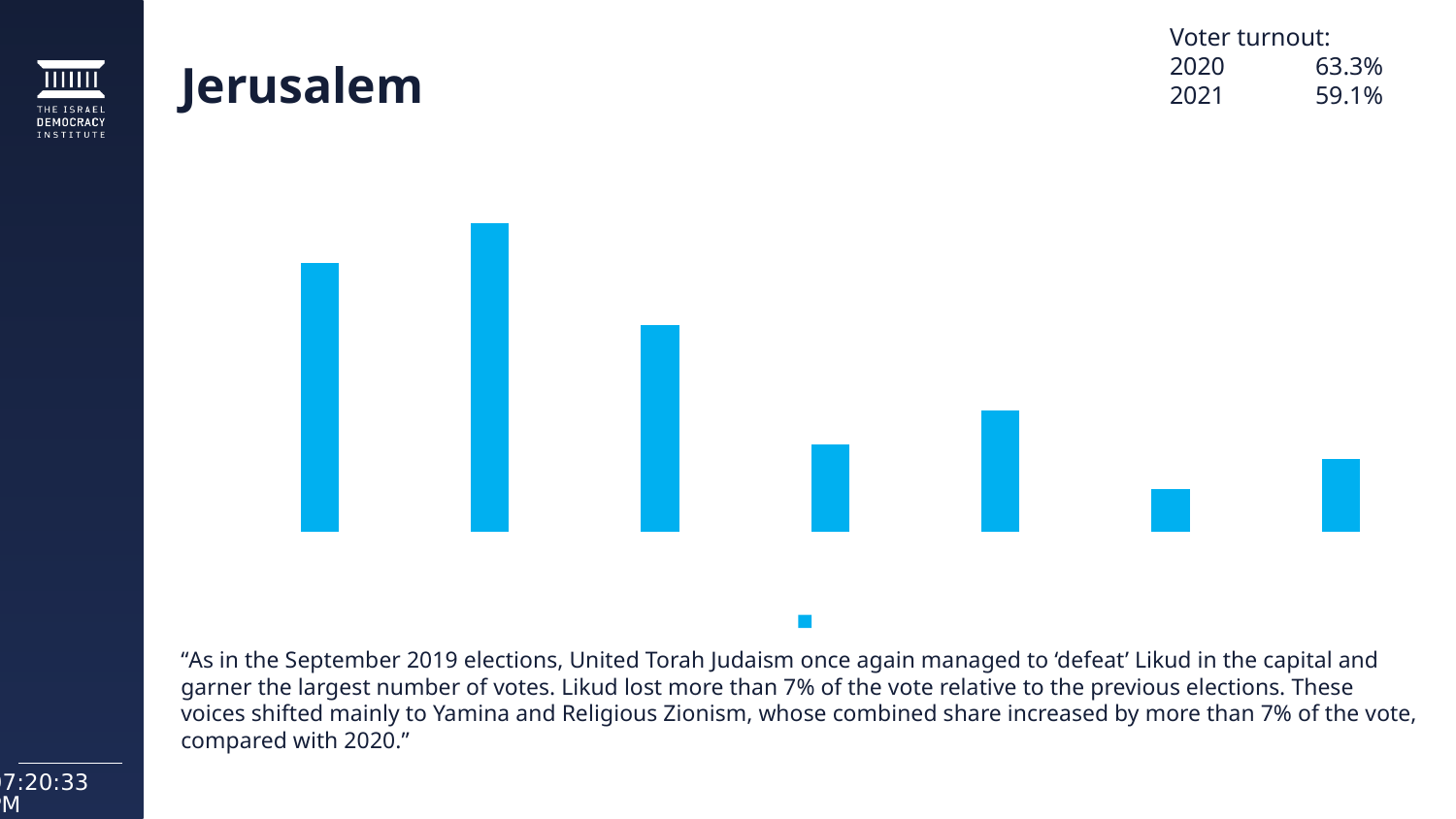
Is the third bar from the left taller or shorter than the fourth bar? taller Counting from the left, which bar in the chart is the tallest? the second bar Counting from the left, which bar in the chart is the shortest? the sixth bar How many bars are plotted in the chart? 7 Is the fifth bar from the left taller or shorter than the seventh bar? taller Is the first bar from the left taller or shorter than the second bar? shorter What is the title shown at the top of the slide above the chart? Jerusalem What colour are the bars in the chart? light blue How many series markers does the legend below the chart show? 1 What kind of chart is shown on the slide? bar chart